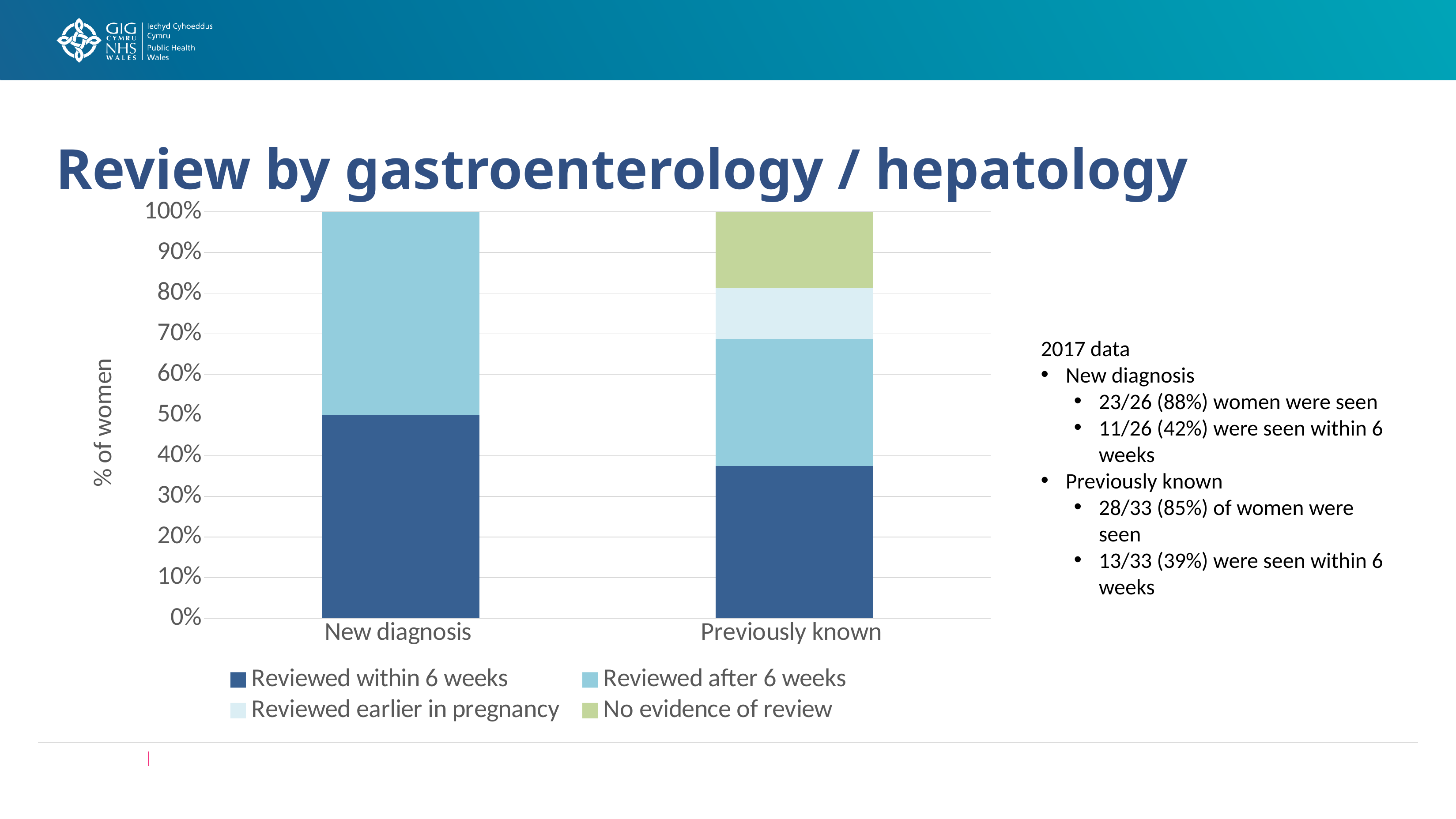
Which category has the larger 'Reviewed after 6 weeks' segment, New diagnosis or Previously known? New diagnosis What is the label on the y axis of the chart? % of women What is the value of 'Reviewed within 6 weeks' for New diagnosis? 50% How many categories are shown on the x axis of the chart? 2 What kind of chart is shown on the slide? Stacked bar chart Is the 'Reviewed within 6 weeks' value for Previously known greater or less than 30%? greater How many series does the chart legend list? 4 Which category has a 'No evidence of review' segment in the chart? Previously known Is the 'Reviewed within 6 weeks' value for Previously known greater or less than 50%? less Is the 'Reviewed after 6 weeks' value for Previously known greater or less than 40%? less What is the total height of the stacked bar for New diagnosis? 100% Which category has the larger 'Reviewed within 6 weeks' segment, New diagnosis or Previously known? New diagnosis